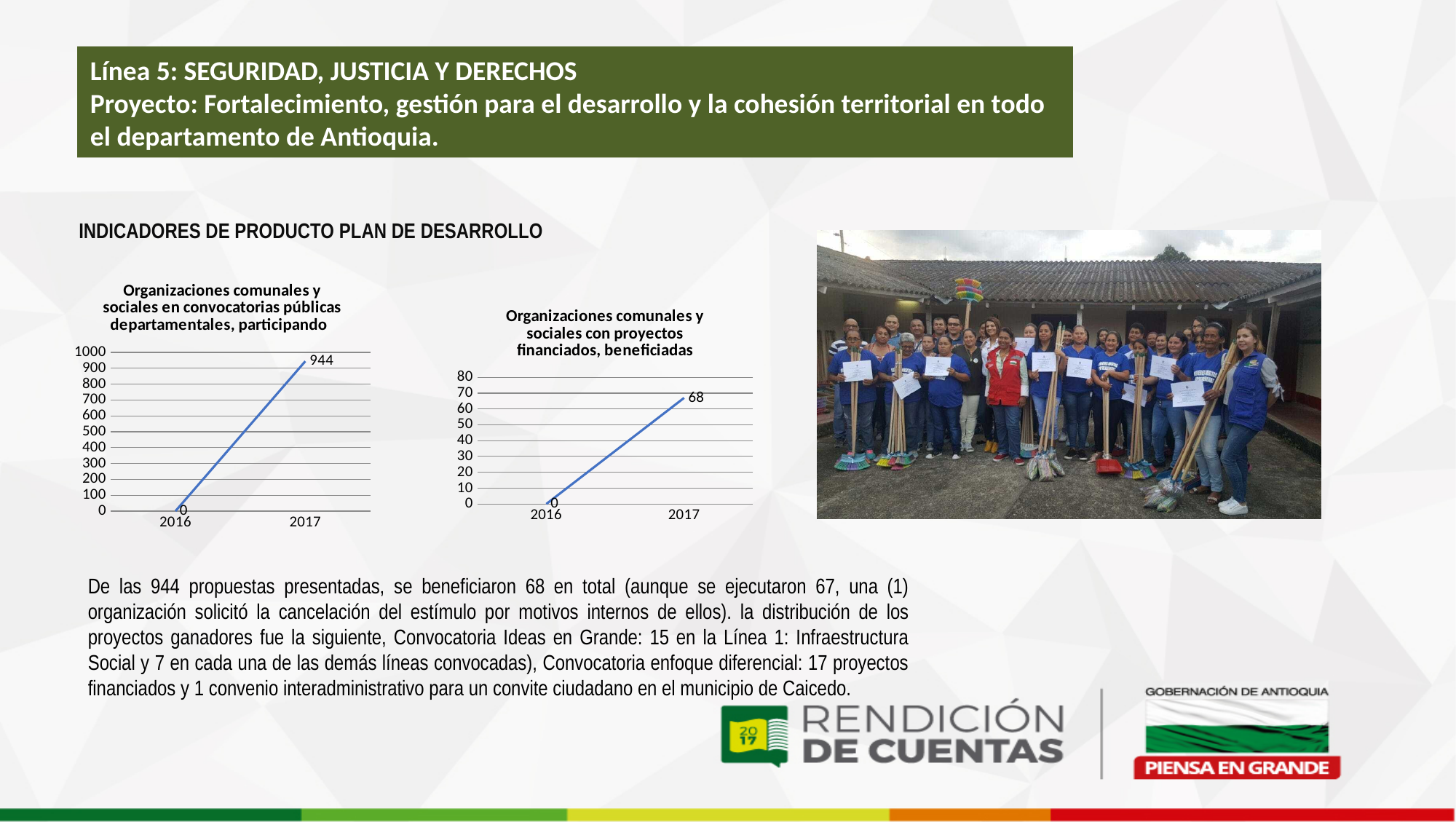
In the left chart, what is the difference between the 2017 and 2016 values? 944 In the right chart, which year has the lowest value? 2016 What kind of chart is the left chart, 'Organizaciones comunales y sociales en convocatorias públicas departamentales, participando'? line chart In the left chart, is the value for 2017 greater or less than 900? greater In the right chart, do the values rise or fall from 2016 to 2017? rise How many data points are plotted in the left chart? 2 In the chart 'Organizaciones comunales y sociales con proyectos financiados, beneficiadas', what is the value for 2016? 0 In the chart 'Organizaciones comunales y sociales con proyectos financiados, beneficiadas', what is the value for 2017? 68 In the left chart, which year has the highest value? 2017 In the chart 'Organizaciones comunales y sociales en convocatorias públicas departamentales, participando', what is the value for 2017? 944 In the right chart, what is the difference between the 2017 and 2016 values? 68 In the chart 'Organizaciones comunales y sociales en convocatorias públicas departamentales, participando', what is the value for 2016? 0